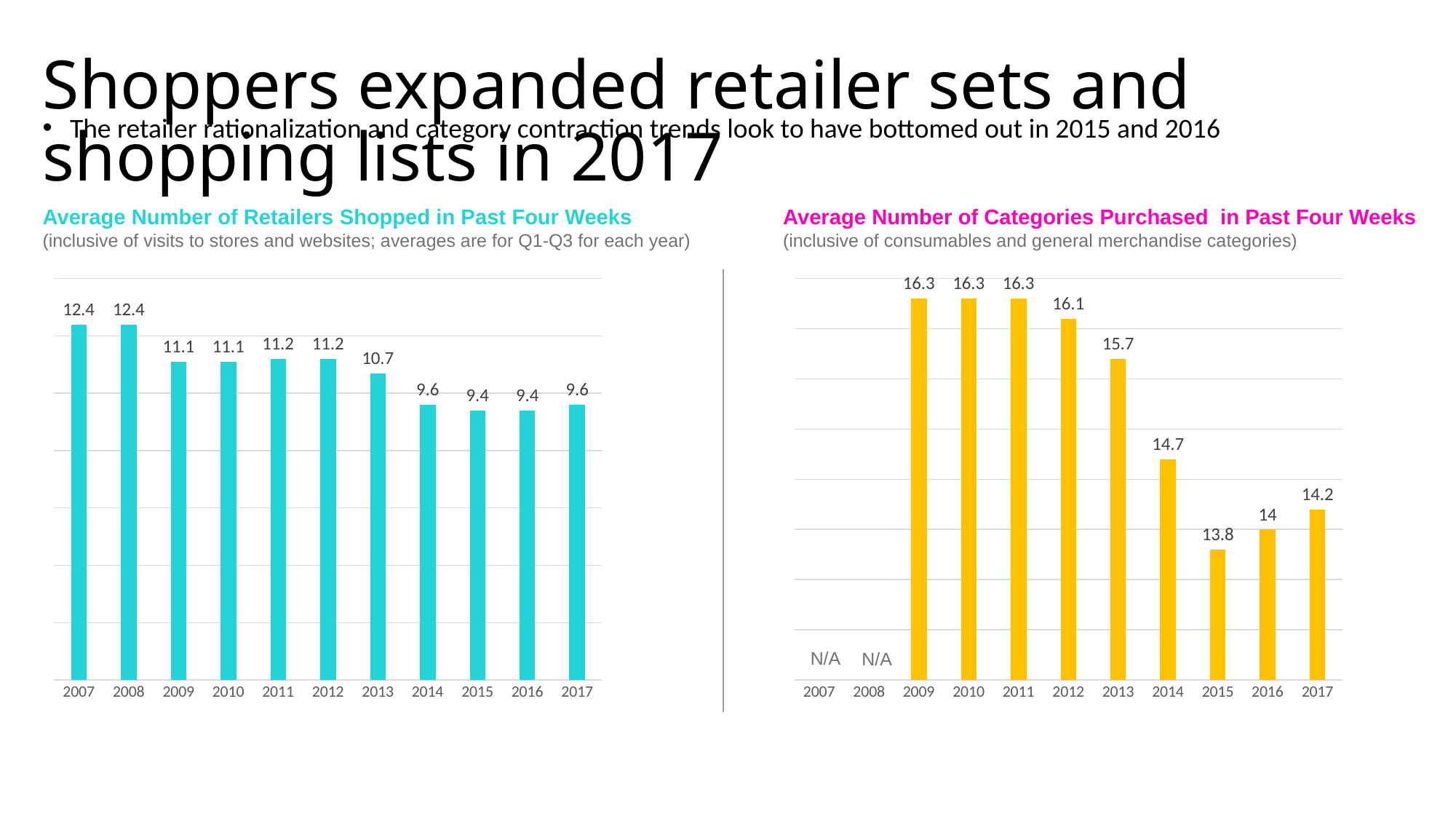
In the 'Average Number of Categories Purchased in Past Four Weeks' chart, what is the value for 2016? 14 In the 'Average Number of Categories Purchased in Past Four Weeks' chart, which year has the lowest plotted value? 2015 In the 'Average Number of Retailers Shopped in Past Four Weeks' chart, what is the value for 2013? 10.7 In the 'Average Number of Categories Purchased in Past Four Weeks' chart, what is shown for 2007 and 2008? N/A In the 'Average Number of Retailers Shopped in Past Four Weeks' chart, what is the value for 2017? 9.6 In the 'Average Number of Retailers Shopped in Past Four Weeks' chart, what is the difference between the 2007 value and the 2015 value? 3 In the 'Average Number of Retailers Shopped in Past Four Weeks' chart, which years have the lowest value? 2015 and 2016 What kind of chart is the 'Average Number of Retailers Shopped in Past Four Weeks' chart? Bar chart In the 'Average Number of Categories Purchased in Past Four Weeks' chart, what is the difference between the 2012 value and the 2013 value? 0.4 In the 'Average Number of Categories Purchased in Past Four Weeks' chart, what is the value for 2014? 14.7 In the 'Average Number of Categories Purchased in Past Four Weeks' chart, is the value for 2012 larger or smaller than the value for 2017? larger In the 'Average Number of Retailers Shopped in Past Four Weeks' chart, how many years are shown on the x axis? 11